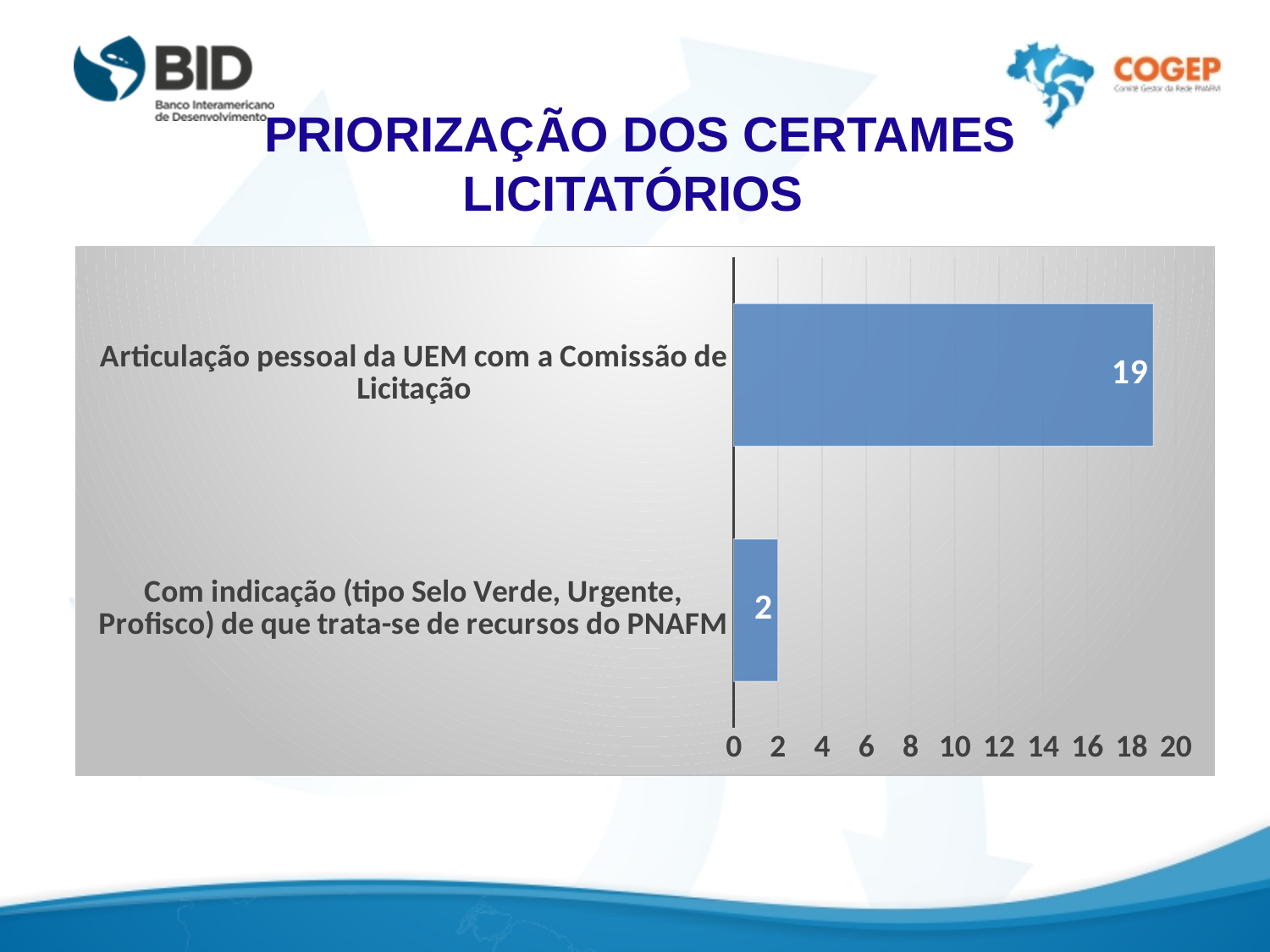
What is the value for "Com indicação (tipo Selo Verde, Urgente, Profisco) de que trata-se de recursos do PNAFM"? 2 What is the title of the slide? PRIORIZAÇÃO DOS CERTAMES LICITATÓRIOS What is the total of the two values shown in the chart? 21 Is the value for "Articulação pessoal da UEM com a Comissão de Licitação" greater or less than 10? greater What is the value for "Articulação pessoal da UEM com a Comissão de Licitação"? 19 Which category has the lowest value? Com indicação (tipo Selo Verde, Urgente, Profisco) de que trata-se de recursos do PNAFM Which is larger: the value for "Articulação pessoal da UEM com a Comissão de Licitação" or the value for "Com indicação (tipo Selo Verde, Urgente, Profisco) de que trata-se de recursos do PNAFM"? Articulação pessoal da UEM com a Comissão de Licitação How many categories are shown in the chart? 2 What kind of chart is shown on the slide? bar chart What is the difference between the values for "Articulação pessoal da UEM com a Comissão de Licitação" and "Com indicação (tipo Selo Verde, Urgente, Profisco) de que trata-se de recursos do PNAFM"? 17 Is the value for "Com indicação (tipo Selo Verde, Urgente, Profisco) de que trata-se de recursos do PNAFM" greater or less than 10? less Which category has the highest value? Articulação pessoal da UEM com a Comissão de Licitação